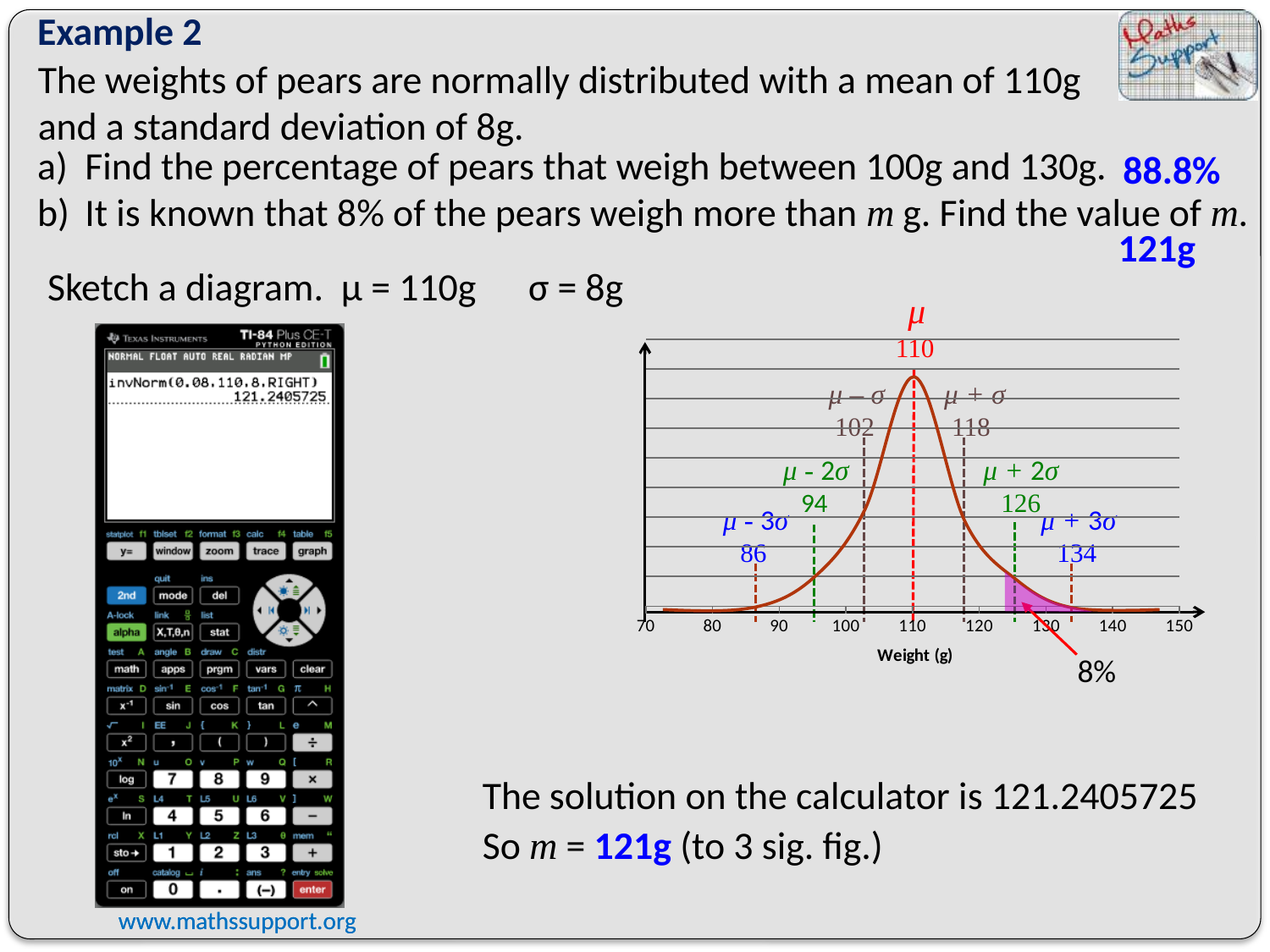
What value is marked at μ + σ on the chart? 118 What value is marked at μ on the normal distribution chart? 110 What is the highest value shown on the x-axis of the chart? 150 What value is marked at μ − 2σ on the chart? 94 What is the lowest value shown on the x-axis of the chart? 70 What value is marked at μ + 2σ on the chart? 126 What value is marked at μ + 3σ on the chart? 134 What value is marked at μ − σ on the chart? 102 What is the difference between the values marked at μ + σ and μ − σ on the chart? 16 What percentage is labelled for the shaded region in the right tail of the chart? 8% What value is marked at μ − 3σ on the chart? 86 What is the x-axis title of the normal distribution chart? Weight (g)